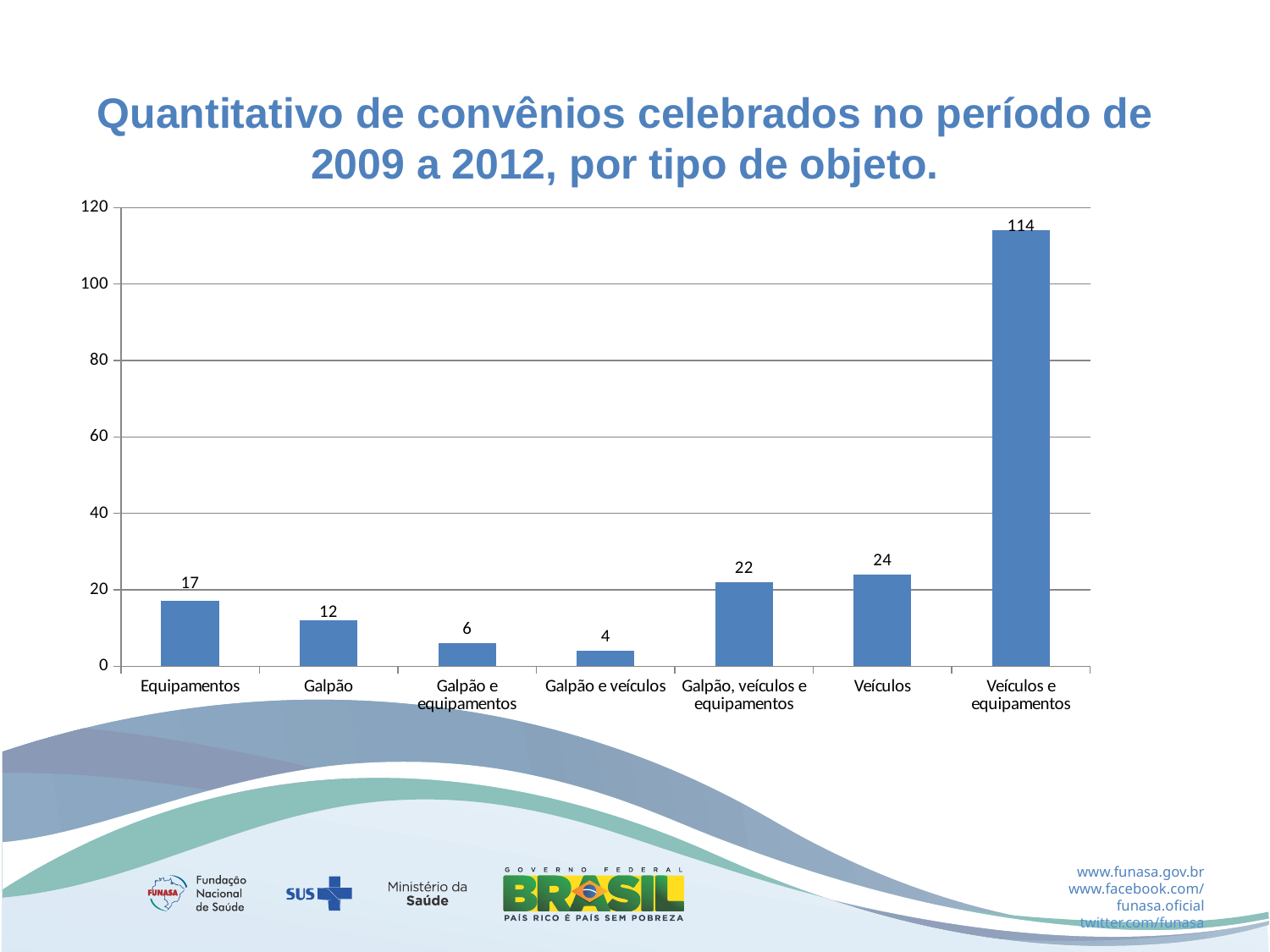
What kind of chart is shown on the slide? bar chart What is the value for Galpão e veículos? 4 Which category has the highest value? Veículos e equipamentos What is the difference between the values for Galpão and Galpão e equipamentos? 6 Which is larger, the value for Veículos or the value for Equipamentos? Veículos What is the value for Equipamentos? 17 What is the difference between the values for Veículos e equipamentos and Veículos? 90 How many categories are shown on the x axis? 7 What is the title of the chart? Quantitativo de convênios celebrados no período de 2009 a 2012, por tipo de objeto. What is the value for Galpão, veículos e equipamentos? 22 Which category has the lowest value? Galpão e veículos Is the value for Veículos e equipamentos greater or less than 100? greater